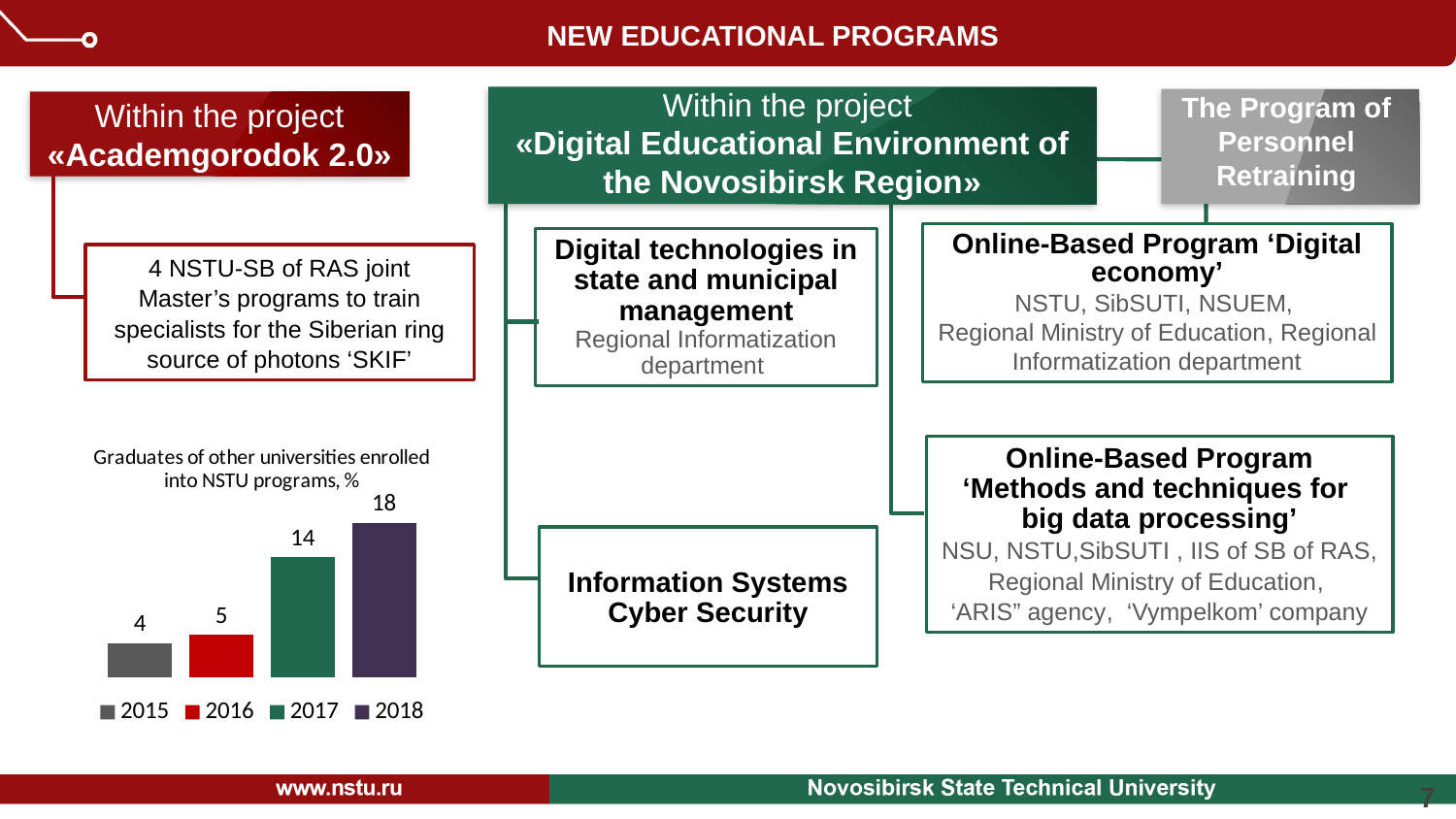
In the chart 'Graduates of other universities enrolled into NSTU programs, %', which is larger, the value for 2016 or the value for 2017? 2017 What is the value for 2015 in the chart 'Graduates of other universities enrolled into NSTU programs, %'? 4 In the chart 'Graduates of other universities enrolled into NSTU programs, %', what is the difference between the values for 2017 and 2015? 10 What is the value for 2018 in the chart 'Graduates of other universities enrolled into NSTU programs, %'? 18 What is the value for 2017 in the chart 'Graduates of other universities enrolled into NSTU programs, %'? 14 How many entries does the legend of the chart 'Graduates of other universities enrolled into NSTU programs, %' list? 4 Which year has the highest value in the chart 'Graduates of other universities enrolled into NSTU programs, %'? 2018 In the chart 'Graduates of other universities enrolled into NSTU programs, %', what is the difference between the values for 2018 and 2017? 4 Which year has the lowest value in the chart 'Graduates of other universities enrolled into NSTU programs, %'? 2015 How many bars are shown in the chart 'Graduates of other universities enrolled into NSTU programs, %'? 4 What kind of chart is 'Graduates of other universities enrolled into NSTU programs, %'? bar chart What is the value for 2016 in the chart 'Graduates of other universities enrolled into NSTU programs, %'? 5